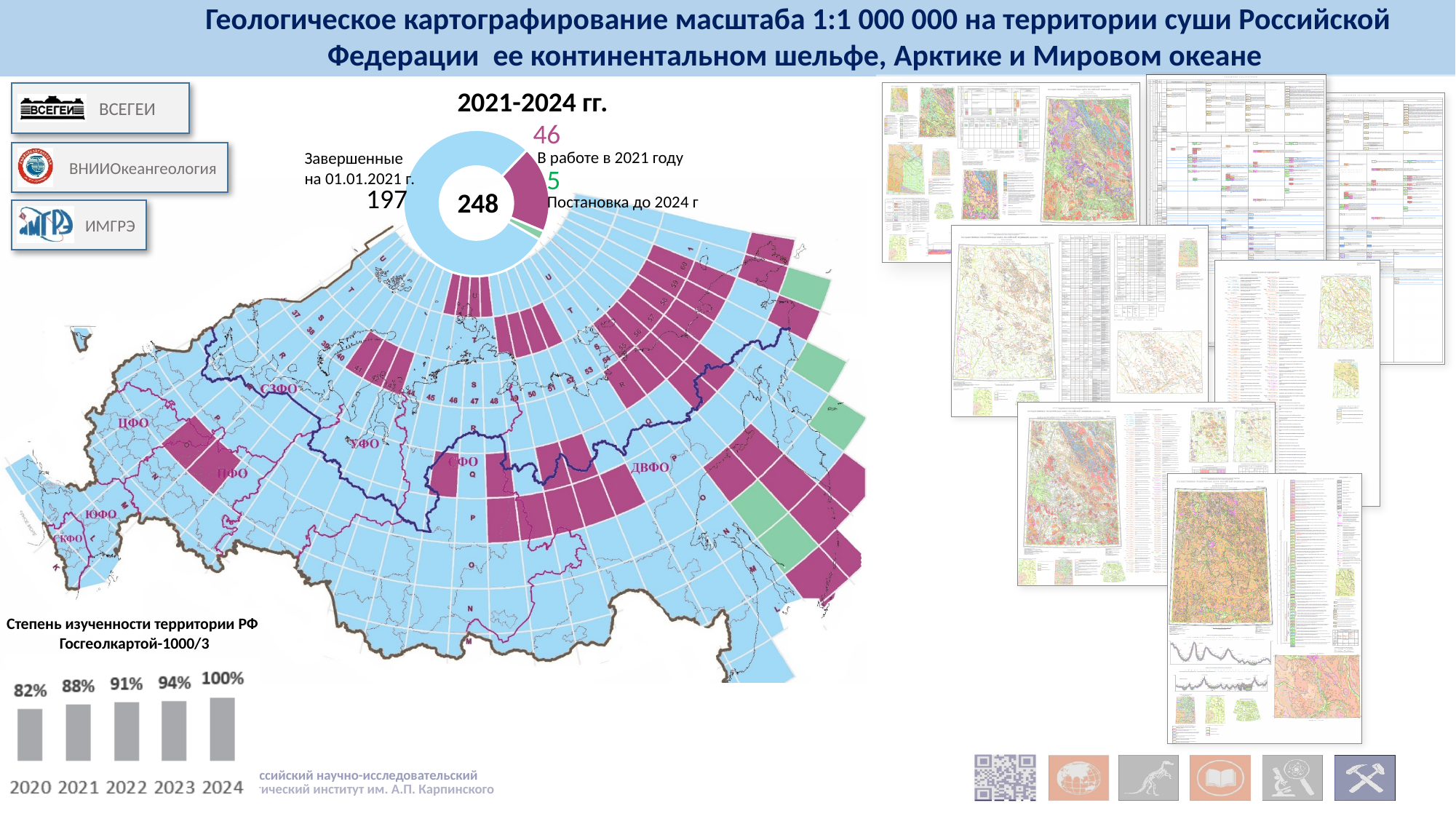
In the bar chart 'Степень изученности территории РФ Госгеолкартой-1000/3', what is the value for 2020? 82% In the bar chart 'Степень изученности территории РФ Госгеолкартой-1000/3', which year has the highest value? 2024 In the doughnut chart '2021-2024 гг.', what number is shown in the centre of the ring? 248 In the doughnut chart '2021-2024 гг.', what is the value for 'Завершенные на 01.01.2021 г.'? 197 In the bar chart 'Степень изученности территории РФ Госгеолкартой-1000/3', do the values rise or fall from 2020 to 2024? rise In the bar chart 'Степень изученности территории РФ Госгеолкартой-1000/3', how many years are shown? 5 In the bar chart 'Степень изученности территории РФ Госгеолкартой-1000/3', what is the difference between the values for 2024 and 2020? 18% In the doughnut chart '2021-2024 гг.', which category has the smallest value? Постановка до 2024 г In the bar chart 'Степень изученности территории РФ Госгеолкартой-1000/3', what is the value for 2022? 91% What kind of chart is the chart titled 'Степень изученности территории РФ Госгеолкартой-1000/3'? bar chart In the bar chart 'Степень изученности территории РФ Госгеолкартой-1000/3', which year has the lowest value? 2020 In the doughnut chart '2021-2024 гг.', what is the value for 'В работе в 2021 году'? 46